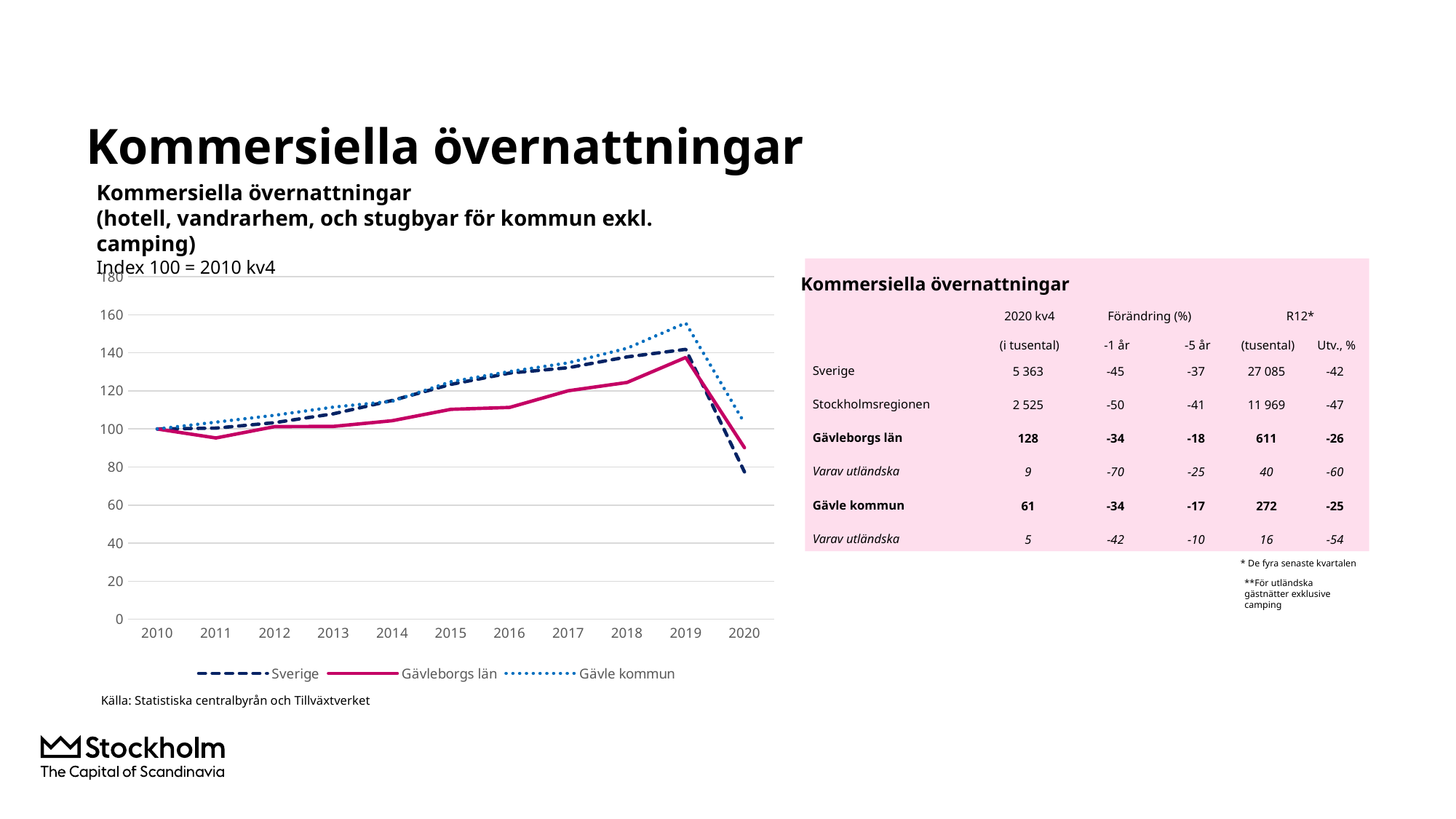
In 2020, which is larger: the value for Gävle kommun or the value for Sverige? Gävle kommun Which series has the lowest value in 2020? Sverige Which series is drawn with a solid line in the chart? Gävleborgs län Does the value for Sverige rise or fall from 2010 to 2019? rise How many years are shown along the x axis of the chart? 11 What kind of chart is shown on the slide? line chart What is the index value for Sverige in 2010? 100 How many series does the chart legend list? 3 Is the value for Gävle kommun in 2019 greater or less than 140? greater Is the value for Gävleborgs län in 2020 greater or less than 100? less Is the value for Sverige in 2020 greater or less than 80? less Which series has the highest value in 2019? Gävle kommun